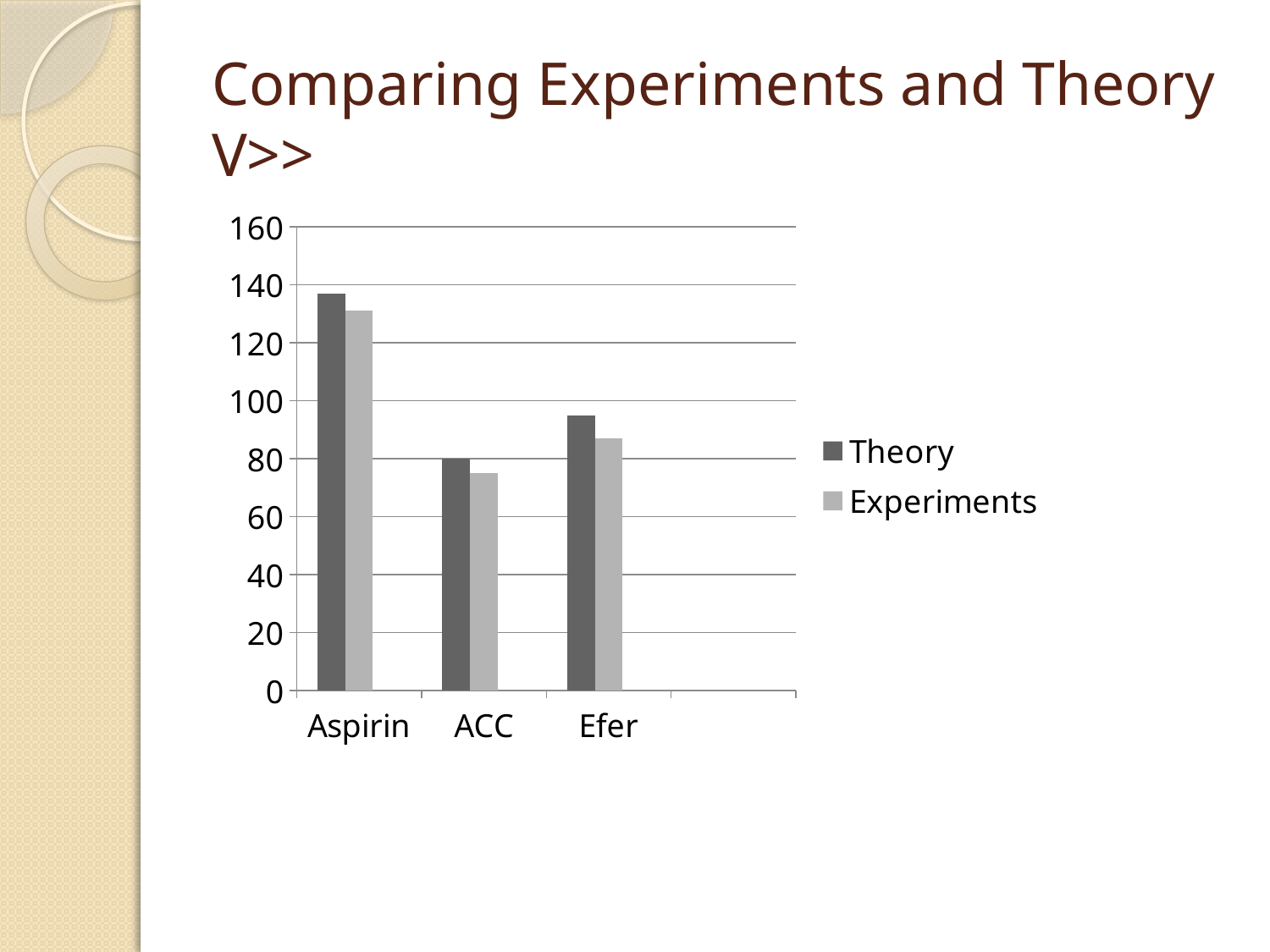
For Aspirin, which is larger: the Theory value or the Experiments value? Theory How many series does the chart's legend list? 2 Which category has the lowest Theory value? ACC For Efer, which is larger: the Theory value or the Experiments value? Theory What are the two series named in the chart's legend? Theory and Experiments How many categories are shown on the x axis of the chart? 3 Is the Theory value for Aspirin greater or less than 120? greater Is the Experiments value for Efer greater or less than 100? less Which category has the lowest Experiments value? ACC What kind of chart is shown on the slide? bar chart Which category has the highest Theory value? Aspirin Does the Theory value rise or fall from Aspirin to ACC? fall